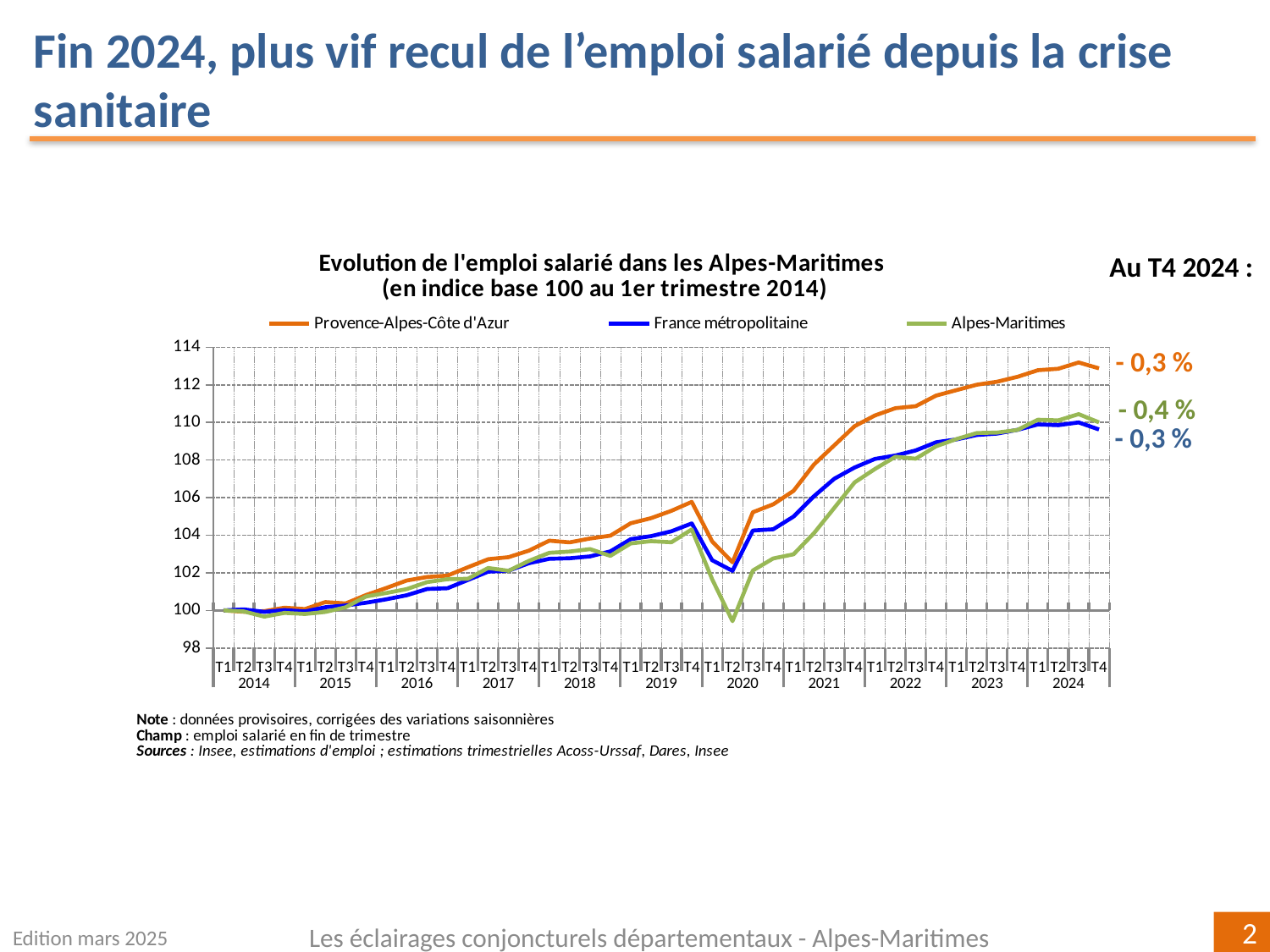
What is the index value of all three series at T1 2014? 100 What kind of chart is shown on the slide? line chart How many years are shown on the x axis? 11 What is the title of the chart? Evolution de l'emploi salarié dans les Alpes-Maritimes (en indice base 100 au 1er trimestre 2014) How many series does the legend list? 3 Which series are listed in the legend? Provence-Alpes-Côte d'Azur, France métropolitaine, Alpes-Maritimes Is the value for Provence-Alpes-Côte d'Azur at T4 2024 greater or less than 112? greater Which series has the lowest value at T2 2020? Alpes-Maritimes What quarterly change is annotated for Alpes-Maritimes at T4 2024? - 0,4 % Which series has the highest value at T4 2024? Provence-Alpes-Côte d'Azur Is the value for Provence-Alpes-Côte d'Azur at T4 2019 greater or less than 104? greater Is the value for Alpes-Maritimes at T2 2020 greater or less than 100? less